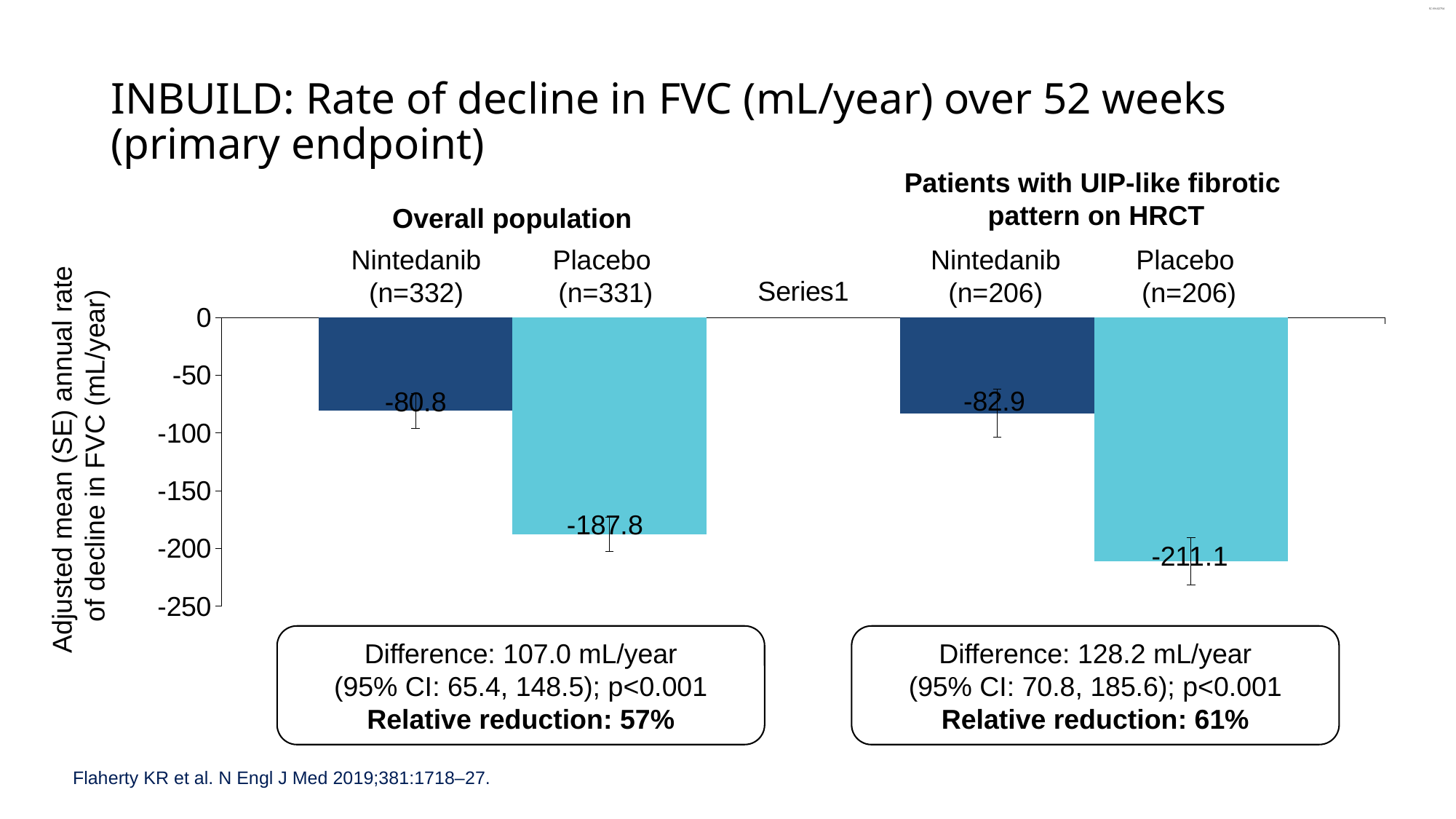
What is the adjusted annual rate of decline in FVC for Nintedanib in the overall population? -80.8 What is the adjusted annual rate of decline in FVC for Placebo in the overall population? -187.8 What kind of chart is shown on the slide? Bar chart What is the difference between the Placebo and Nintedanib values in the overall population? 107.0 What is the difference between the Placebo and Nintedanib values in patients with UIP-like fibrotic pattern on HRCT? 128.2 What is the adjusted annual rate of decline in FVC for Nintedanib in patients with UIP-like fibrotic pattern on HRCT? -82.9 Is the value for Placebo in the overall population greater or less than -150? less Which bar shows the smallest decline in FVC (the value closest to zero)? Nintedanib (n=332) in the overall population What is the adjusted annual rate of decline in FVC for Placebo in patients with UIP-like fibrotic pattern on HRCT? -211.1 What is the label of the y axis? Adjusted mean (SE) annual rate of decline in FVC (mL/year) Which bar shows the largest decline in FVC (the most negative value)? Placebo (n=206) in patients with UIP-like fibrotic pattern on HRCT Which shows a greater decline in FVC: Placebo in the overall population or Placebo in patients with UIP-like fibrotic pattern on HRCT? Placebo in patients with UIP-like fibrotic pattern on HRCT